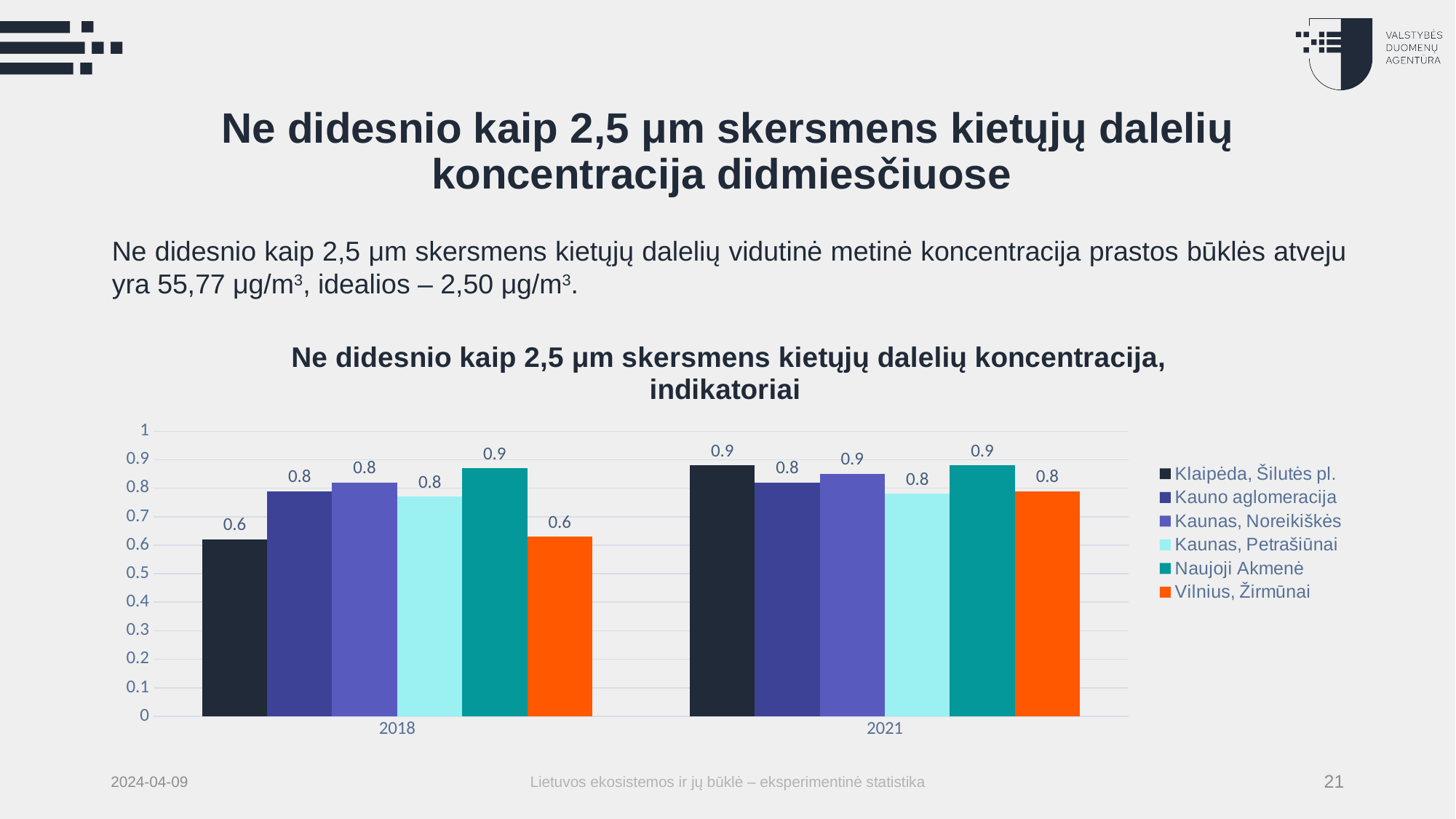
What is the value for Kaunas, Petrašiūnai in 2021? 0.8 Which series has the highest value in 2018? Naujoji Akmenė What is the value for Vilnius, Žirmūnai in 2018? 0.6 What is the value for Naujoji Akmenė in 2021? 0.9 What kind of chart is shown on the slide? Bar chart Is the value for Klaipėda, Šilutės pl. in 2018 greater or less than 0.7? less How many series does the legend list? 6 How many year categories are shown on the x axis? 2 What is the difference between the Klaipėda, Šilutės pl. values in 2021 and 2018? 0.3 Is the value for Kaunas, Noreikiškės in 2021 greater or less than 0.8? greater Which is larger for Vilnius, Žirmūnai: the 2018 value or the 2021 value? 2021 What is the value for Klaipėda, Šilutės pl. in 2018? 0.6